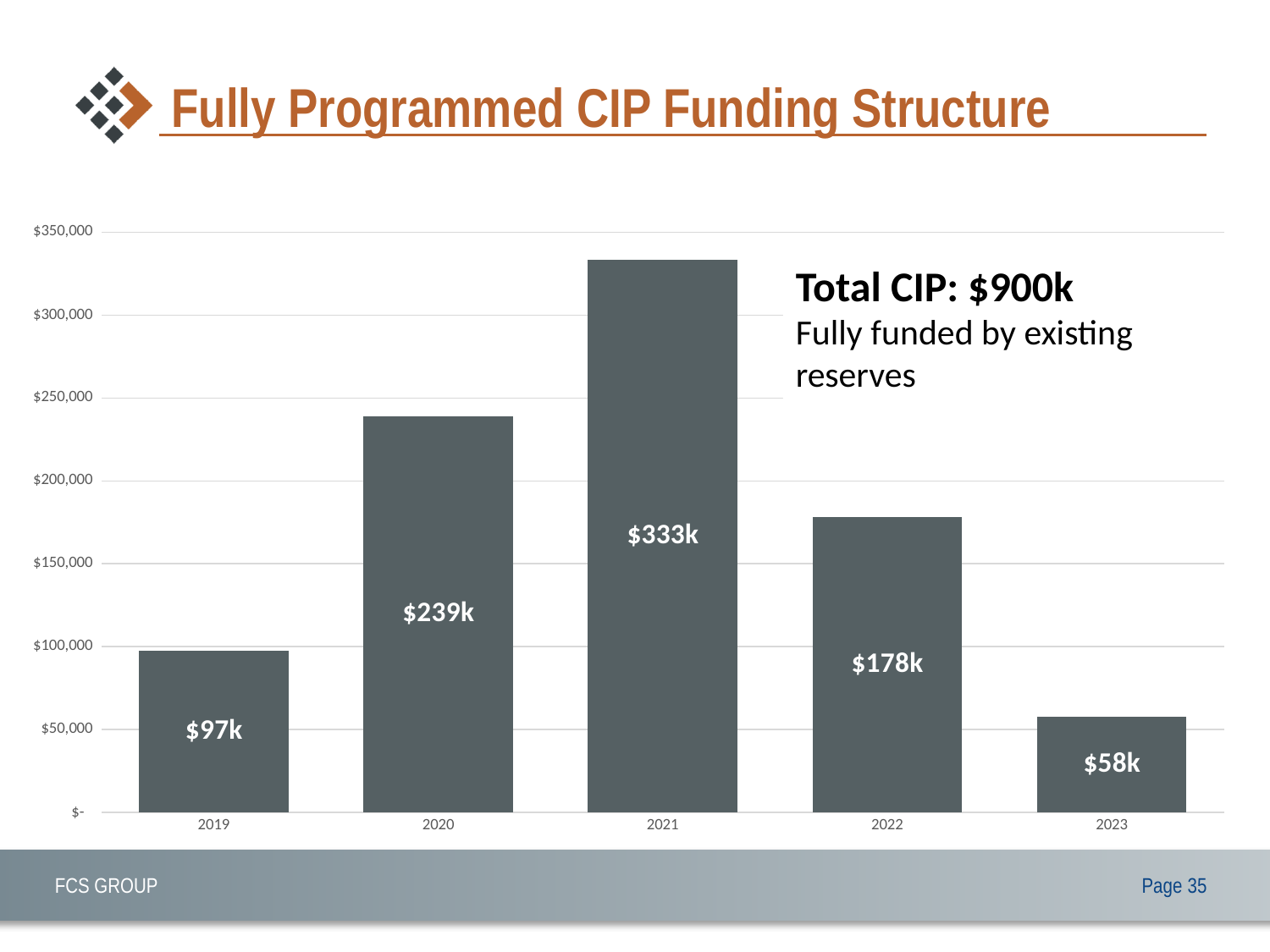
What kind of chart is shown on the slide? bar chart What is the value for 2019? $97k Is the value for 2022 greater or less than $150,000? greater What is the value for 2023? $58k Which year has the highest value? 2021 Which is larger, the value for 2020 or the value for 2022? 2020 Do the values rise or fall from 2021 to 2023? fall What total CIP amount is stated in the text next to the chart? $900k What is the difference between the values for 2021 and 2020? $94k What is the value for 2021? $333k Which year has the lowest value? 2023 How many years are shown on the x axis? 5